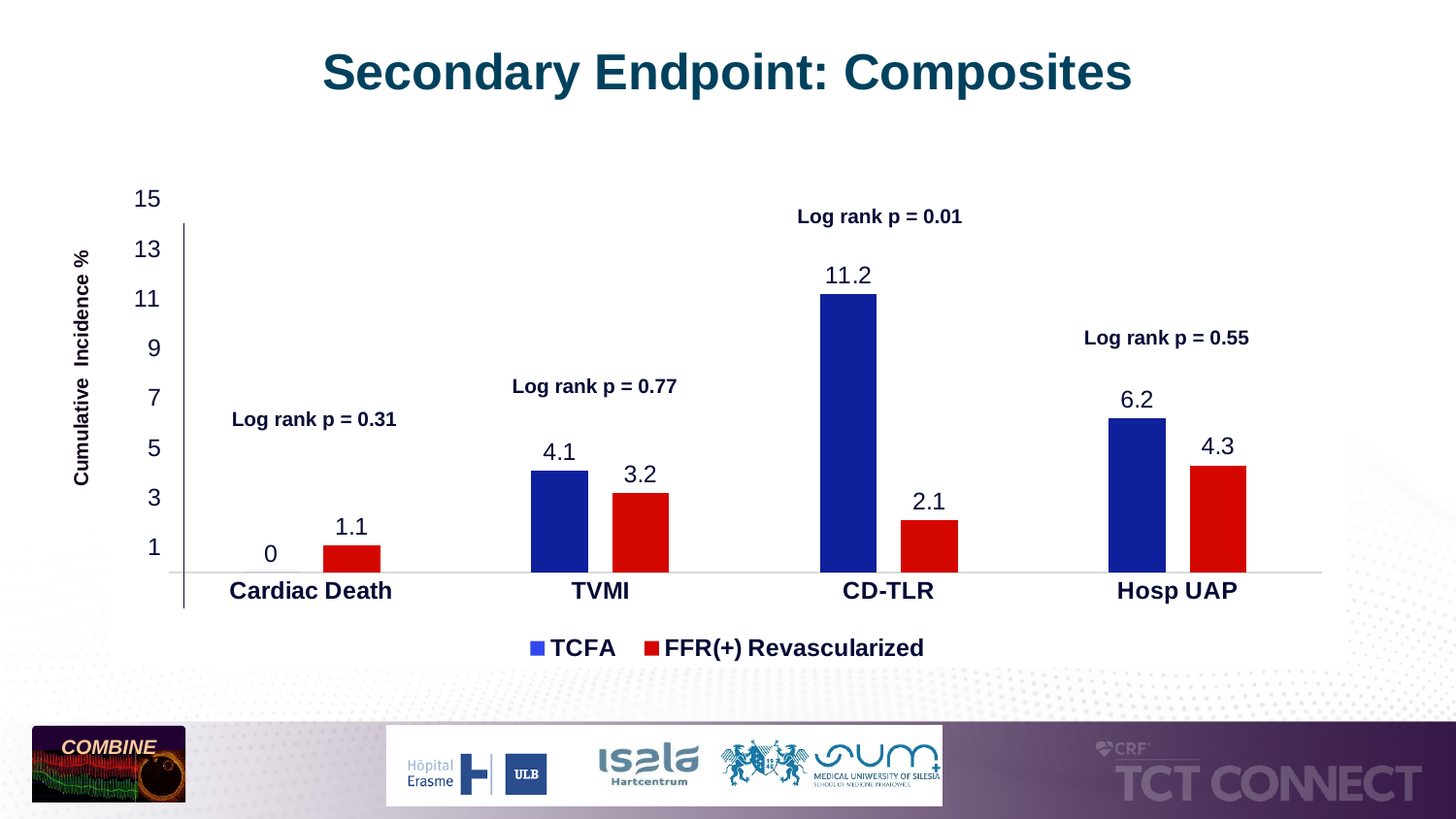
How many series does the legend list? 2 Is the TCFA value for Hosp UAP greater or less than 5? greater What is the value for TCFA in the Cardiac Death category? 0 Which category has the highest TCFA value? CD-TLR What is the log rank p value shown for the CD-TLR category? 0.01 What is the cumulative incidence for TCFA in the CD-TLR category? 11.2 What is the difference between the TCFA and FFR(+) Revascularized values in the CD-TLR category? 9.1 What is the cumulative incidence for FFR(+) Revascularized in the Hosp UAP category? 4.3 What kind of chart is shown on the slide? bar chart How many categories are shown on the x axis? 4 Which category has the lowest FFR(+) Revascularized value? Cardiac Death In the TVMI category, which series has the larger value, TCFA or FFR(+) Revascularized? TCFA